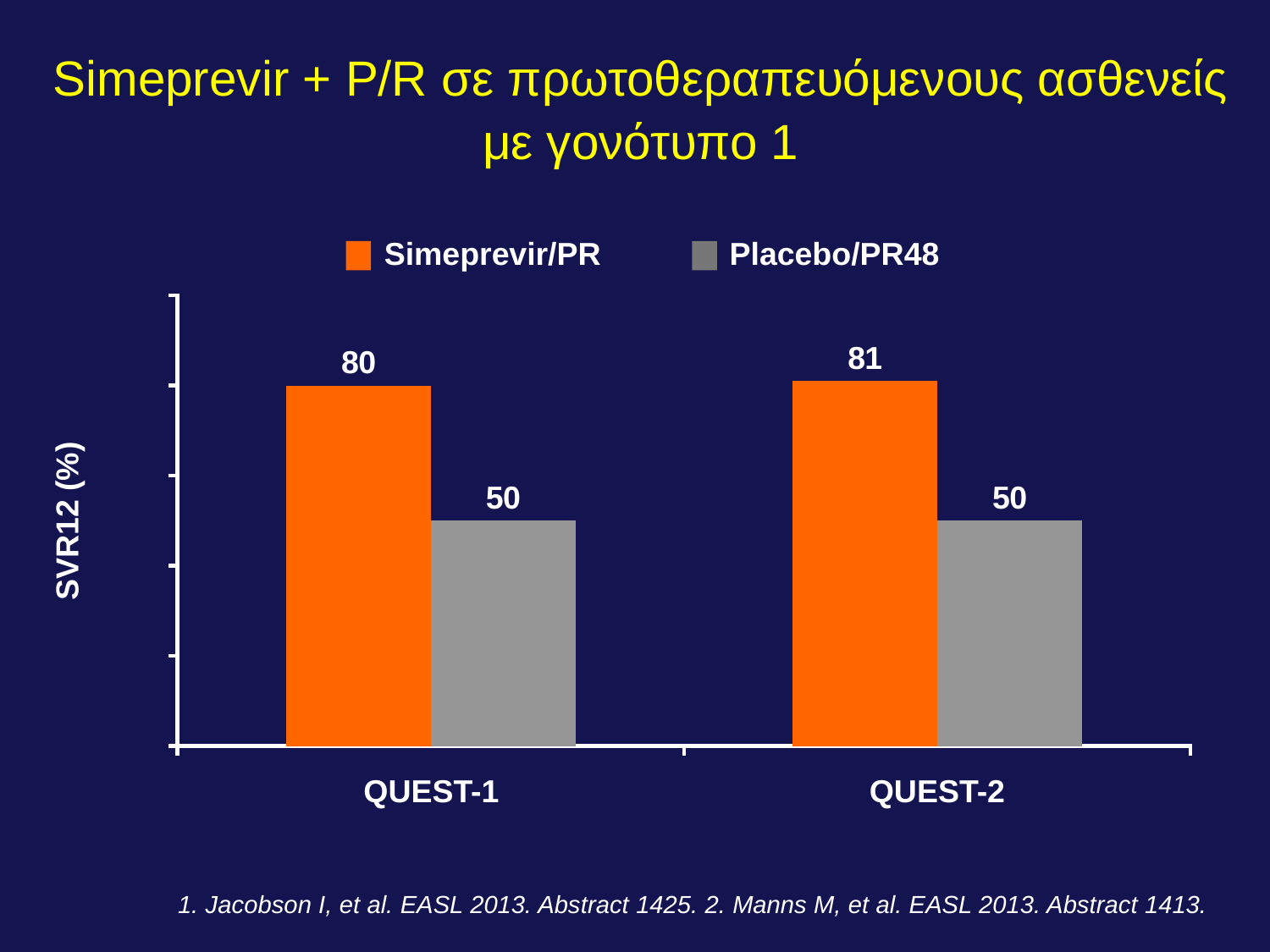
What is the difference between the Simeprevir/PR and Placebo/PR48 SVR12 values in QUEST-2? 31 What is the SVR12 (%) value for Simeprevir/PR in QUEST-2? 81 What kind of chart is shown on the slide? Bar chart How many series does the legend list? 2 What is the SVR12 (%) value for Simeprevir/PR in QUEST-1? 80 How many studies (categories) are shown on the x axis? 2 What is the difference between the Simeprevir/PR and Placebo/PR48 SVR12 values in QUEST-1? 30 What is the SVR12 (%) value for Placebo/PR48 in QUEST-2? 50 What is the label of the y axis? SVR12 (%) In QUEST-2, which arm has the larger SVR12 value, Simeprevir/PR or Placebo/PR48? Simeprevir/PR Which colour represents the Placebo/PR48 series? Grey Which study has the higher Simeprevir/PR SVR12 value, QUEST-1 or QUEST-2? QUEST-2